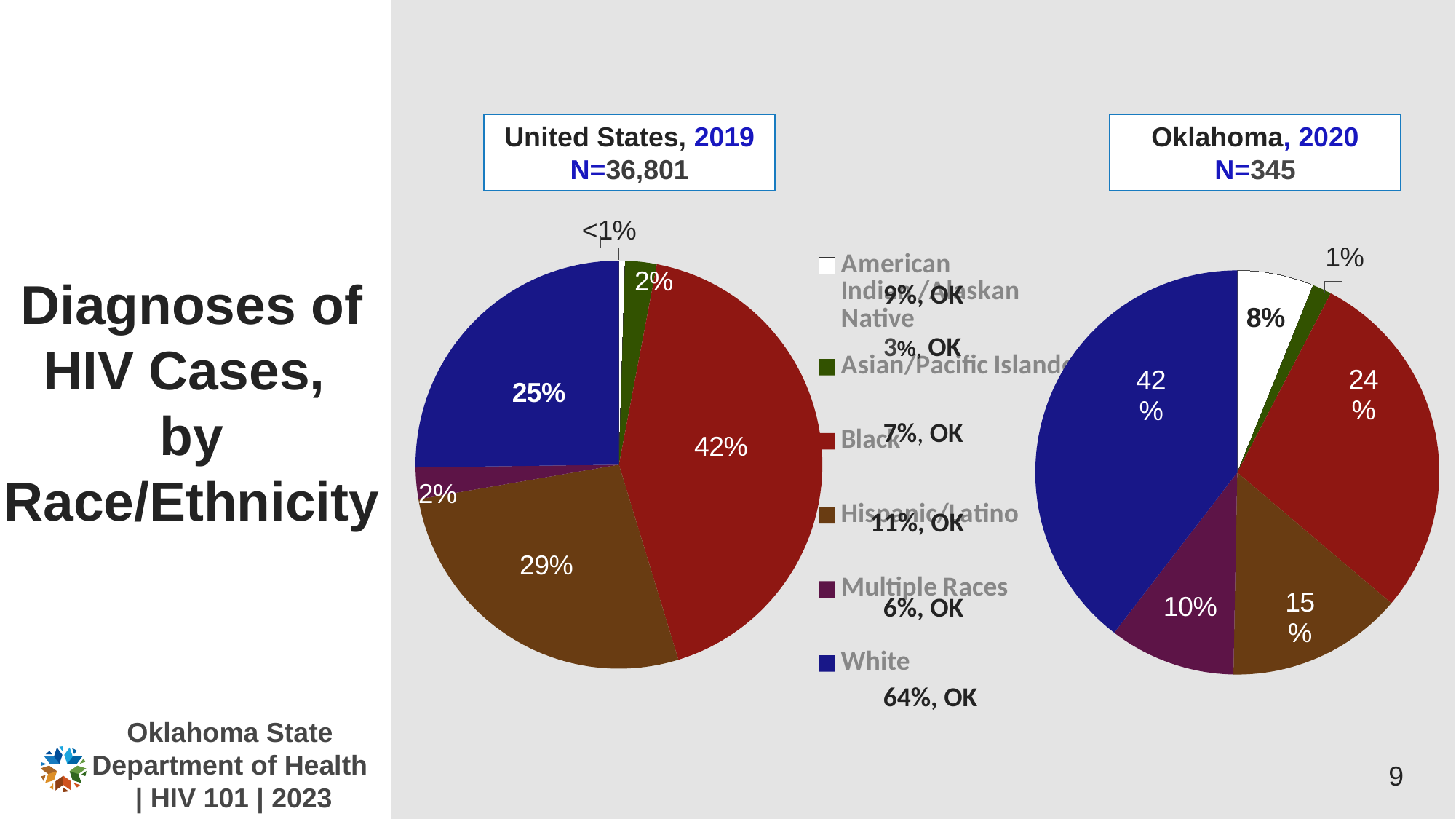
In the United States, 2019 pie chart, what percentage of HIV diagnoses is shown for Black? 42% In the Oklahoma, 2020 pie chart, which race/ethnicity has the largest slice? White In the Oklahoma, 2020 pie chart, which race/ethnicity has the smallest slice? Asian/Pacific Islander What kind of charts are shown on the slide? Pie charts In the Oklahoma, 2020 pie chart, what percentage is shown for American Indian/Alaskan Native? 8% How many race/ethnicity categories does the legend list? 6 In the Oklahoma, 2020 pie chart, what percentage is shown for White? 42% In the Oklahoma, 2020 pie chart, what percentage is shown for Hispanic/Latino? 15% In the United States, 2019 pie chart, which race/ethnicity has the largest slice? Black In the Oklahoma, 2020 pie chart, how many percentage points larger is the White slice than the Black slice? 18 percentage points In the United States, 2019 pie chart, which is larger: the Hispanic/Latino slice or the White slice? Hispanic/Latino In the United States, 2019 pie chart, what percentage is shown for Hispanic/Latino? 29%